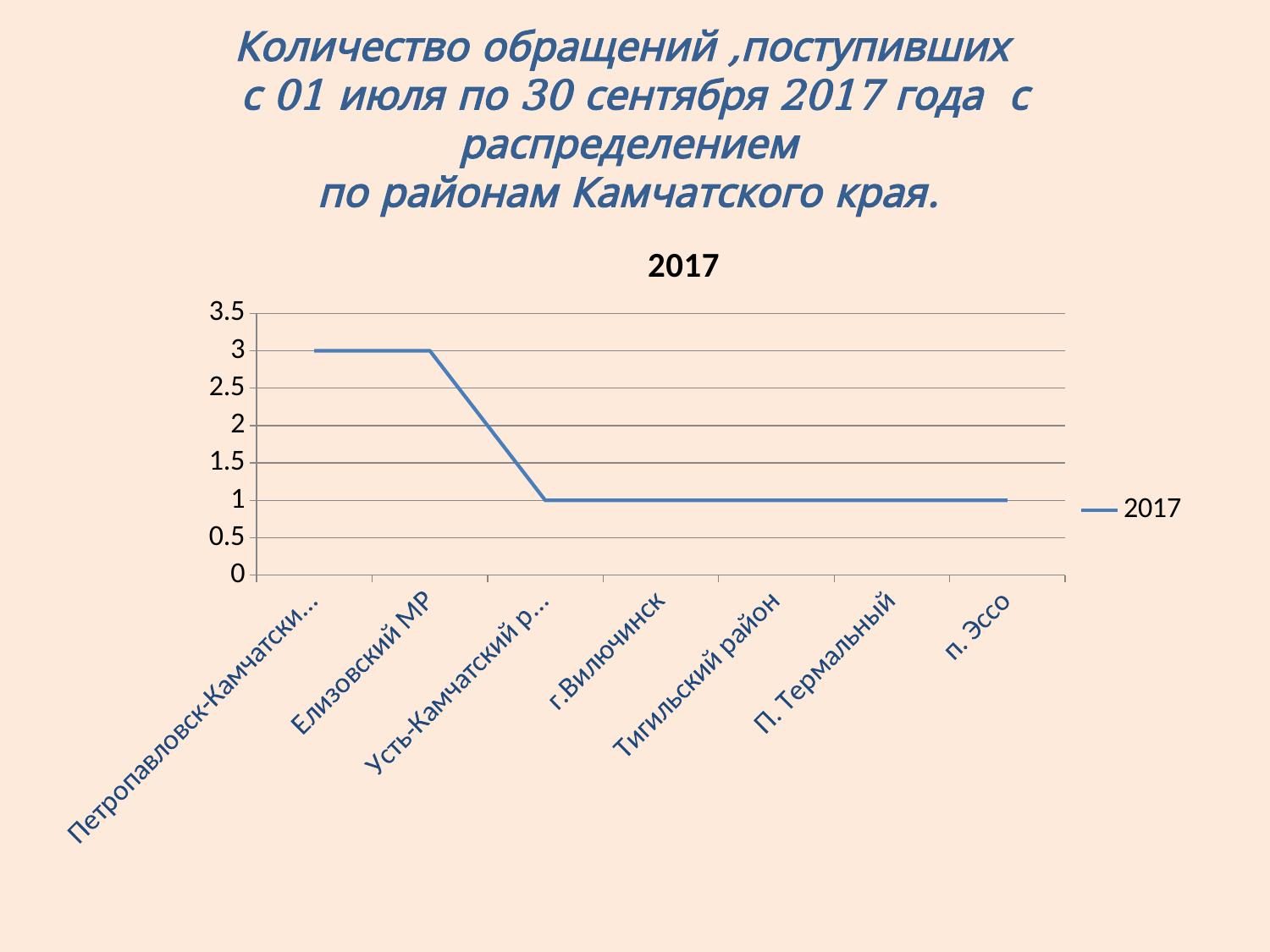
What entry does the legend show? 2017 What is the value for Елизовский МР? 3 Do the values rise or fall moving from left to right along the x axis? fall What kind of chart is shown on the slide? line chart How many categories are plotted along the x axis? 7 Which has the larger value, Елизовский МР or г.Вилючинск? Елизовский МР Is the value for Елизовский МР greater or less than 2? greater What is the difference between the values for Елизовский МР and П. Термальный? 2 What is the value for п. Эссо? 1 What is the value for Тигильский район? 1 What is the value for г.Вилючинск? 1 How many series does the legend list? 1